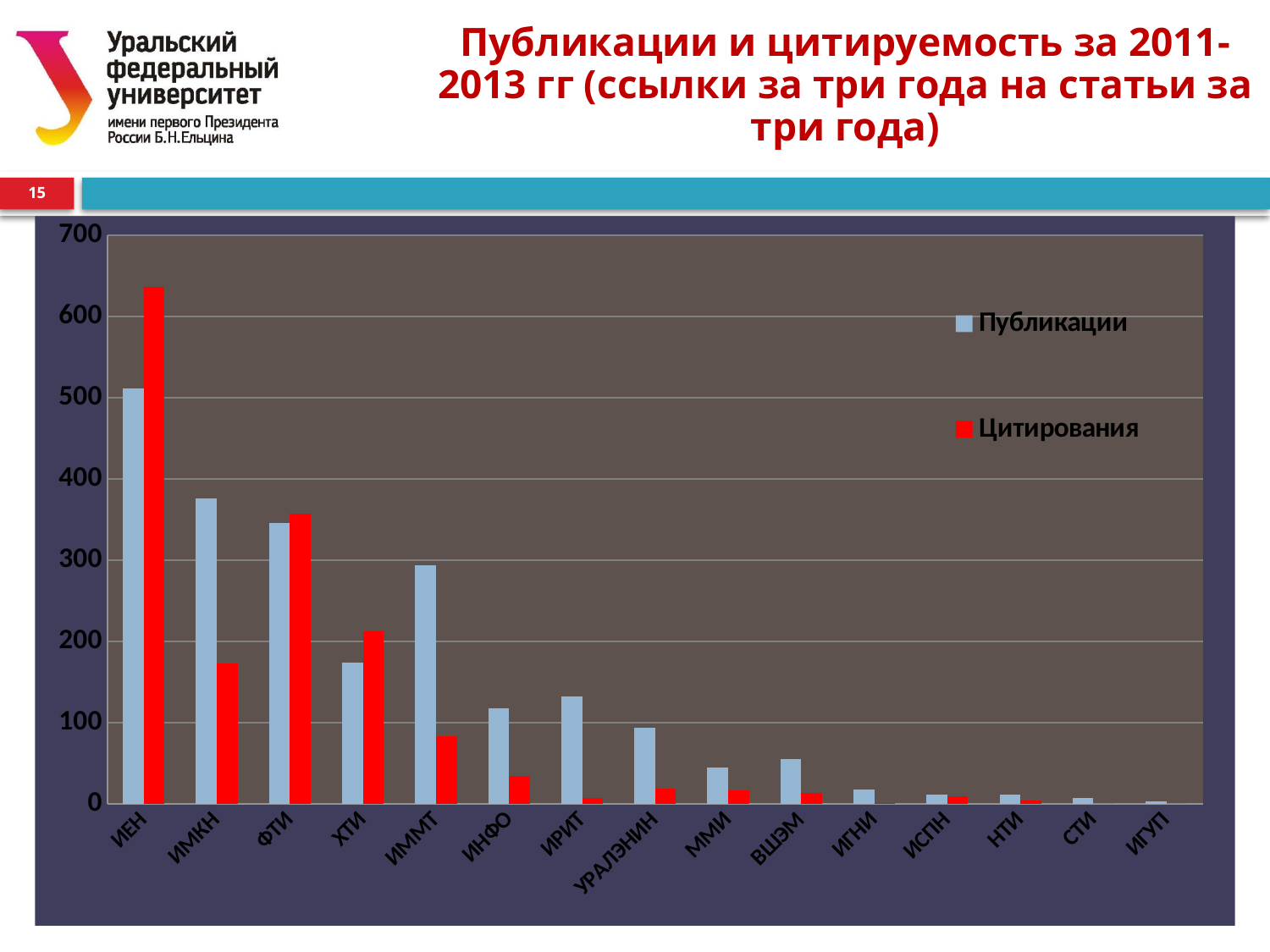
Is the Цитирования value for ИЕН greater or less than 600? greater Is the Цитирования value for ИММТ greater or less than 100? less Is the Публикации value for ИМКН greater or less than 300? greater How many series does the legend list? 2 How many categories (institutes) are shown along the x axis? 15 Which category has the highest value for Цитирования? ИЕН What kind of chart is shown on the slide? bar chart For ХТИ, which is larger: Публикации or Цитирования? Цитирования What colour represents the Цитирования series in the legend? red Which category has the highest value for Публикации? ИЕН For ИМКН, which is larger: Публикации or Цитирования? Публикации